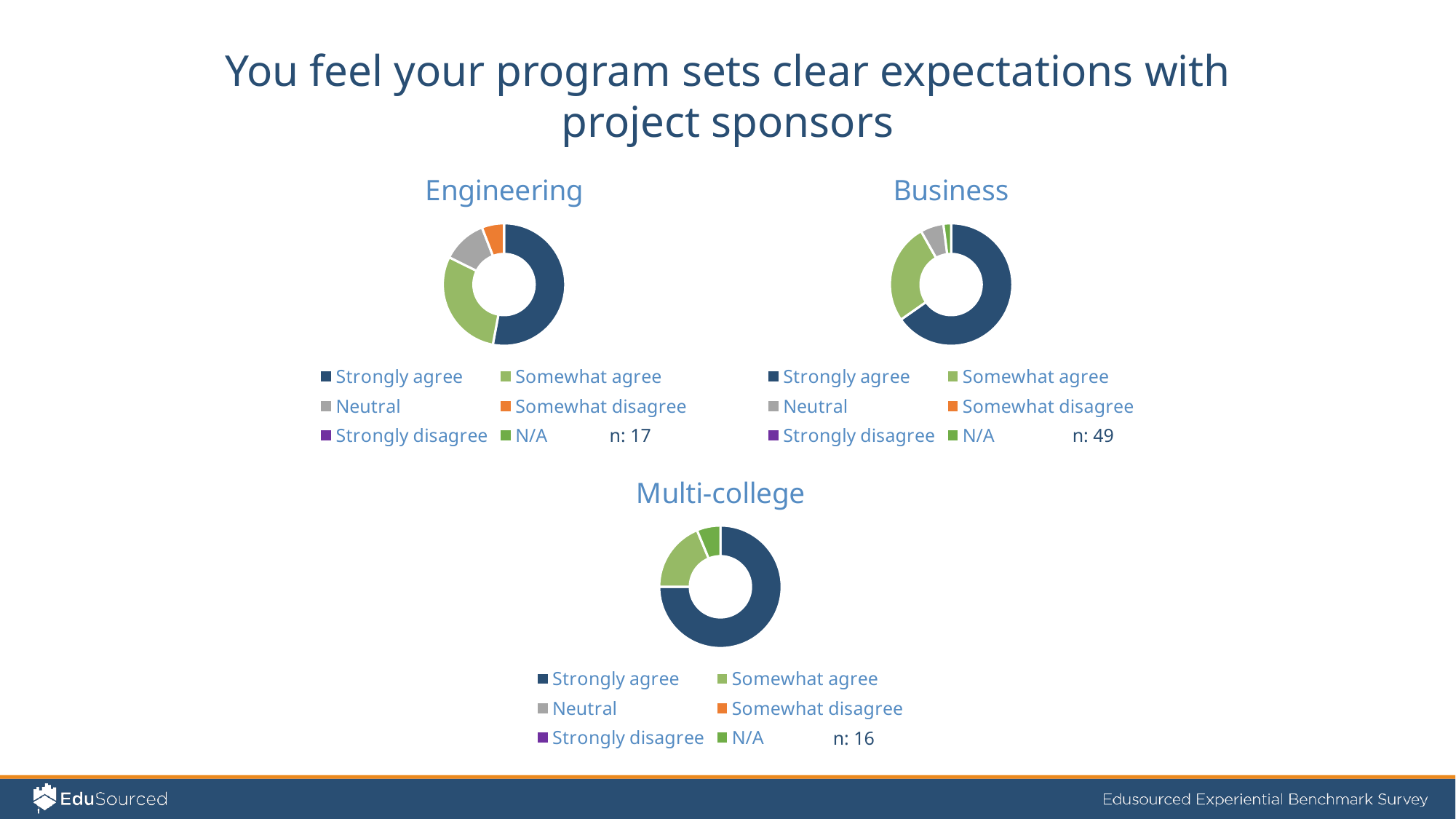
What kind of chart is used for the Engineering data? Donut chart How many entries does the legend of the Engineering chart list? 6 In the Multi-college chart, which response category has the largest share? Strongly agree What is the sample size (n) shown for the Multi-college chart? n: 16 In the Business chart, which response category has the largest share? Strongly agree In the Engineering chart, which is larger: the Neutral slice or the Somewhat disagree slice? Neutral How many donut charts are shown on the slide? 3 In the Multi-college chart, which is larger: the Somewhat agree slice or the N/A slice? Somewhat agree In the Engineering chart, which response category has the largest share? Strongly agree What is the sample size (n) shown for the Business chart? n: 49 In the Business chart, which is larger: the Somewhat agree slice or the Neutral slice? Somewhat agree